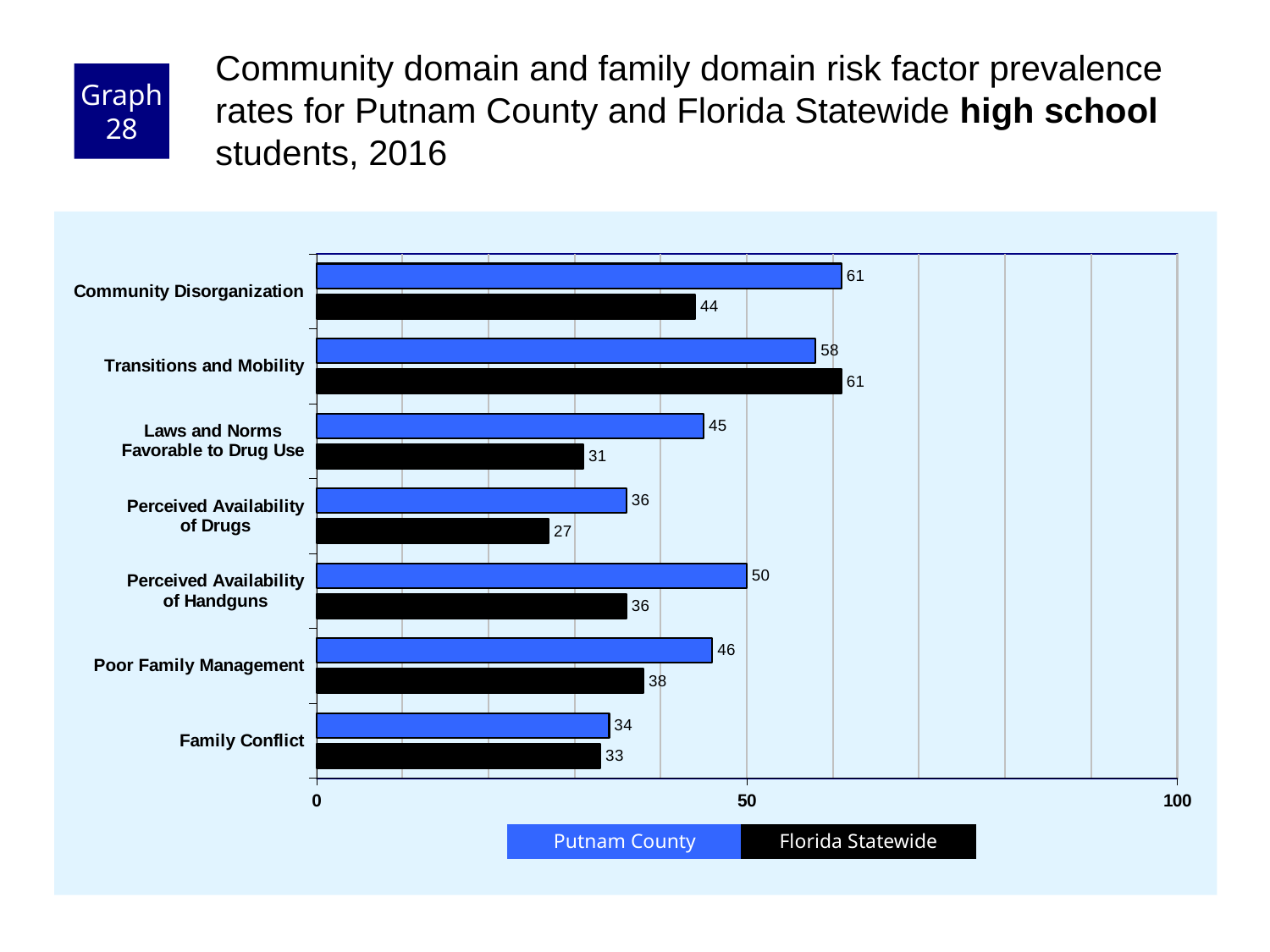
Which risk factor has the highest Florida Statewide value? Transitions and Mobility Which is larger for Transitions and Mobility: the Putnam County value or the Florida Statewide value? Florida Statewide Which colour represents Florida Statewide in the chart? Black What kind of chart is shown on the slide? Bar chart What is the Florida Statewide value for Perceived Availability of Drugs? 27 What is the Florida Statewide value for Transitions and Mobility? 61 What is the Putnam County value for Community Disorganization? 61 Which risk factor has the lowest Putnam County value? Family Conflict How many series does the legend list? 2 How many risk factors are shown on the chart? 7 What is the difference between the Putnam County and Florida Statewide values for Perceived Availability of Handguns? 14 Is the Putnam County value for Poor Family Management greater or less than 50? less